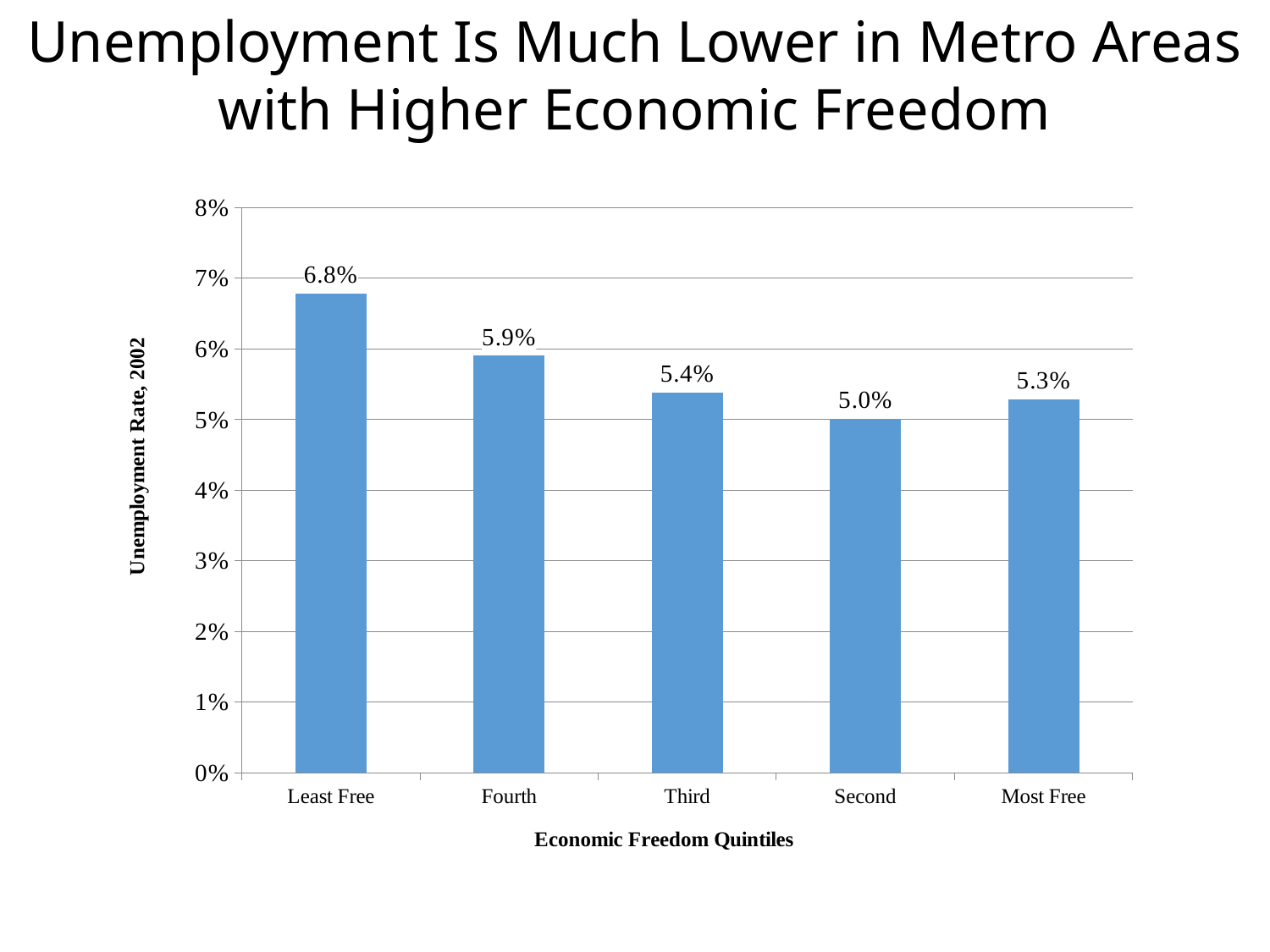
What is the label of the vertical axis? Unemployment Rate, 2002 How many economic freedom quintiles are shown on the chart? 5 What is the unemployment rate for the Least Free quintile? 6.8% What kind of chart is shown on the slide? bar chart Which quintile has the lowest unemployment rate? Second What is the difference in unemployment rate between the Fourth and Third quintiles? 0.5% What is the difference in unemployment rate between the Least Free and Most Free quintiles? 1.5% Is the unemployment rate for the Third quintile greater or less than 6%? less Which has a higher unemployment rate, the Fourth quintile or the Most Free quintile? Fourth Which quintile has the highest unemployment rate? Least Free What is the unemployment rate for the Second quintile? 5.0% What is the unemployment rate for the Most Free quintile? 5.3%